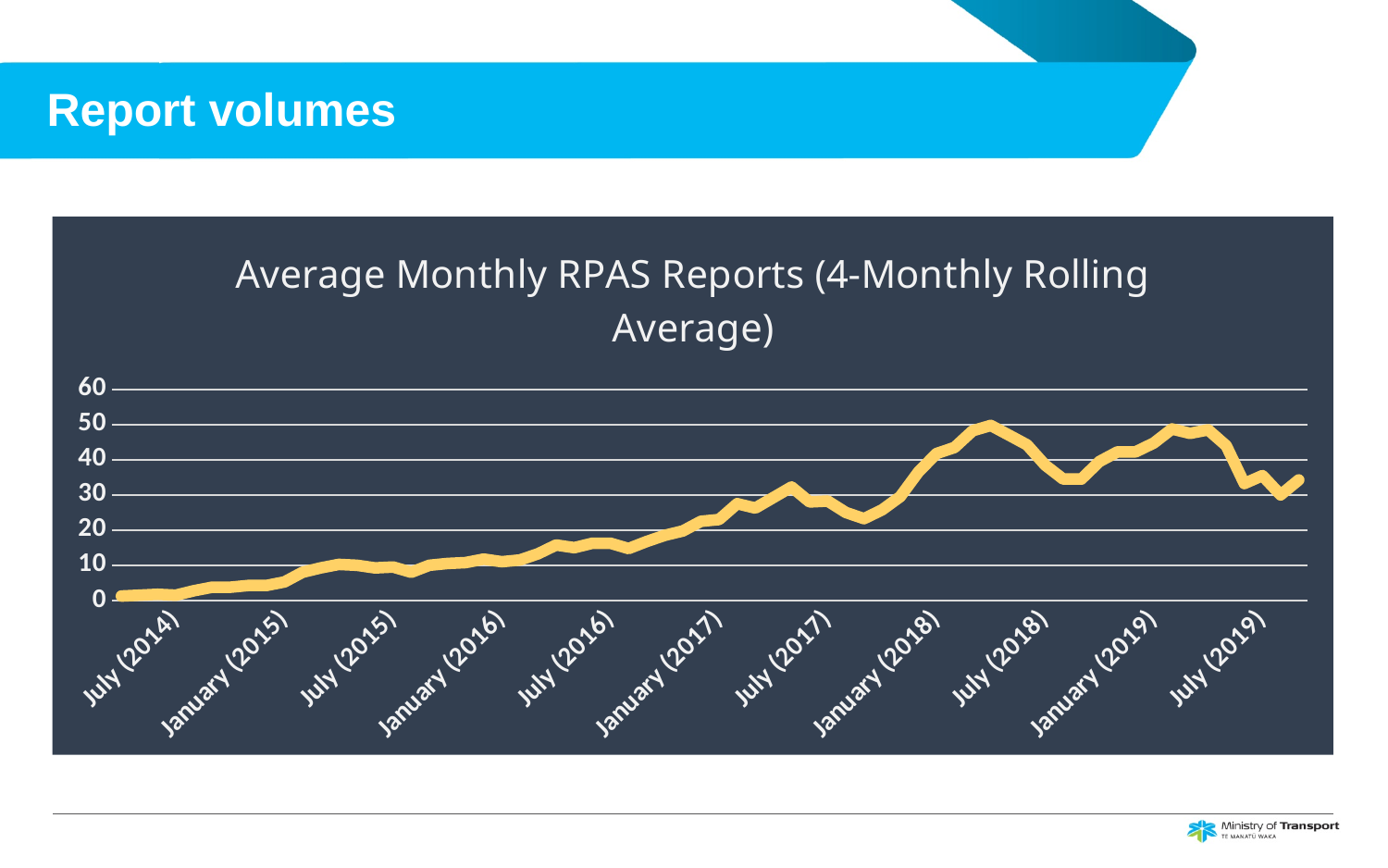
What kind of chart is shown on the slide? line chart What is the title of the chart? Average Monthly RPAS Reports (4-Monthly Rolling Average) Is the value for July (2014) greater or less than 10? less Is the value for July (2019) greater or less than 40? less Is the value for January (2015) greater or less than 10? less Which is larger, the value for July (2018) or the value for July (2016)? July (2018) Do the values generally rise or fall from July (2014) to July (2018)? rise How many labelled points are shown on the x axis? 11